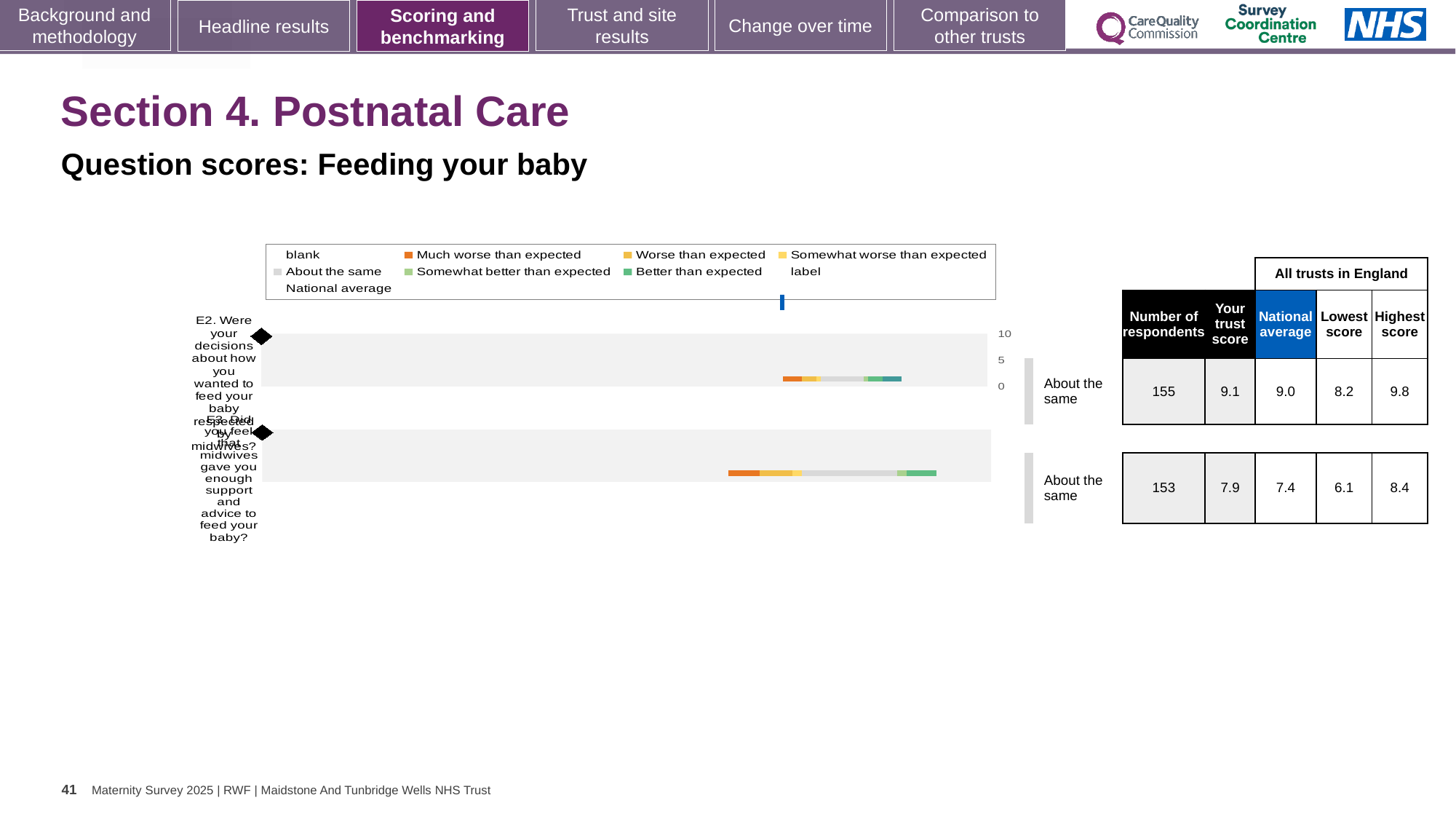
Which question has the highest national average? E2 What colour does the legend use for 'Much worse than expected'? orange What is the trust score for question E2 about decisions on how to feed your baby being respected by midwives? 9.1 What kind of chart is shown on the slide? bar chart What benchmark category is shown for question E3? About the same How many respondents answered question E3? 153 How many questions (categories) are plotted in the chart? 2 What is the difference between the highest and lowest scores for question E3? 2.3 What is the national average for question E3 about midwives giving enough support and advice to feed your baby? 7.4 What is the difference between the trust score and the national average for question E2? 0.1 Which question has the higher trust score, E2 or E3? E2 What is the highest score among all trusts in England for question E2? 9.8